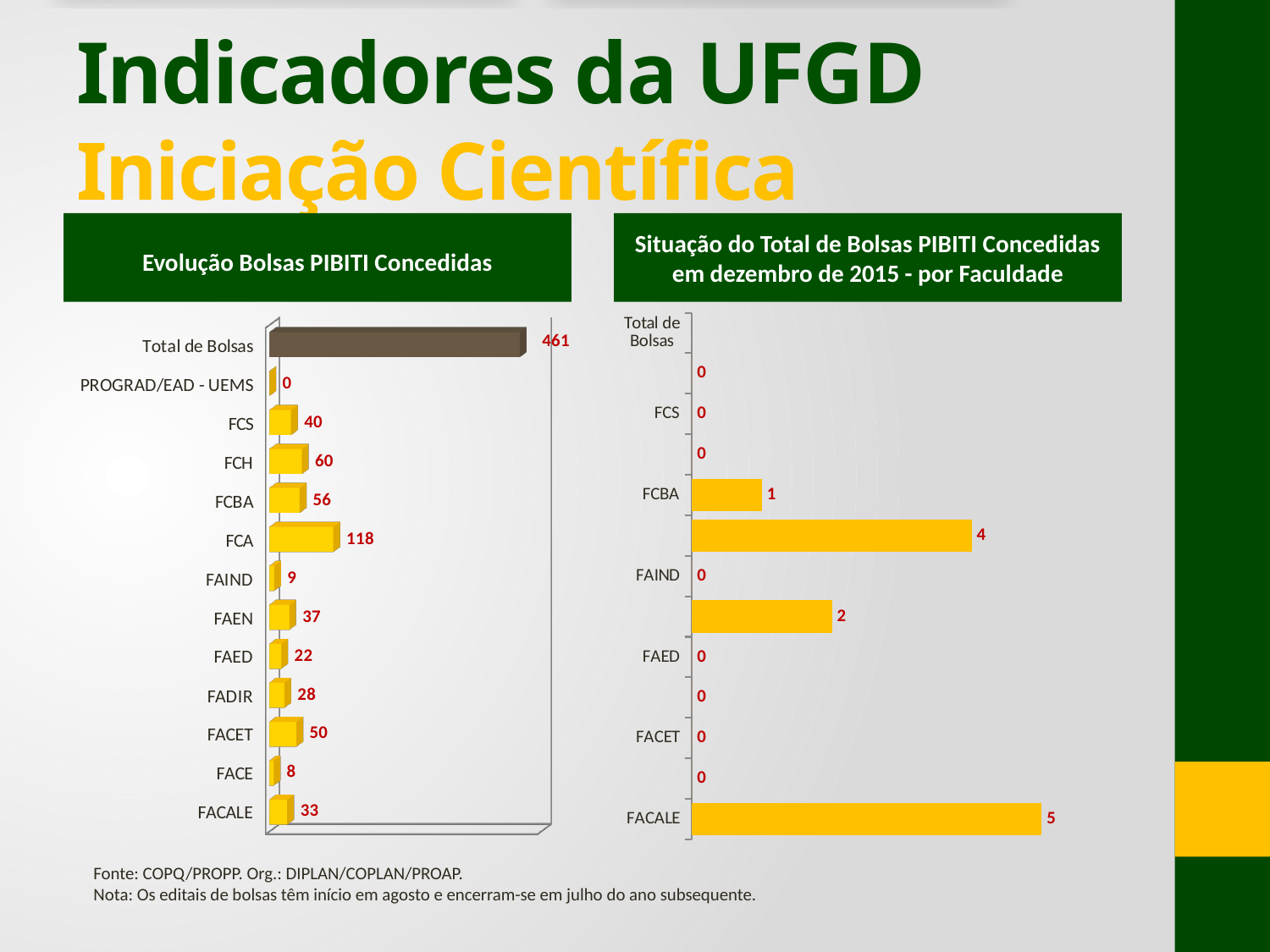
In the chart 'Situação do Total de Bolsas PIBITI Concedidas em dezembro de 2015 - por Faculdade', what is the value for FCBA? 1 How many categories are shown in the chart 'Evolução Bolsas PIBITI Concedidas'? 13 In the chart 'Evolução Bolsas PIBITI Concedidas', what is the value for FACET? 50 In the chart 'Situação do Total de Bolsas PIBITI Concedidas em dezembro de 2015 - por Faculdade', which category has the highest value? FACALE In the chart 'Evolução Bolsas PIBITI Concedidas', what is the value for FCA? 118 In the chart 'Evolução Bolsas PIBITI Concedidas', what is the value for Total de Bolsas? 461 In the chart 'Evolução Bolsas PIBITI Concedidas', which category has the lowest value? PROGRAD/EAD - UEMS In the chart 'Evolução Bolsas PIBITI Concedidas', which is larger, the value for FAEN or the value for FACALE? FAEN In the chart 'Evolução Bolsas PIBITI Concedidas', which faculty (excluding Total de Bolsas) has the highest value? FCA What type of chart is 'Evolução Bolsas PIBITI Concedidas'? Bar chart In the chart 'Evolução Bolsas PIBITI Concedidas', what is the difference between the values for FCH and FCS? 20 In the chart 'Situação do Total de Bolsas PIBITI Concedidas em dezembro de 2015 - por Faculdade', what is the value for FACALE? 5